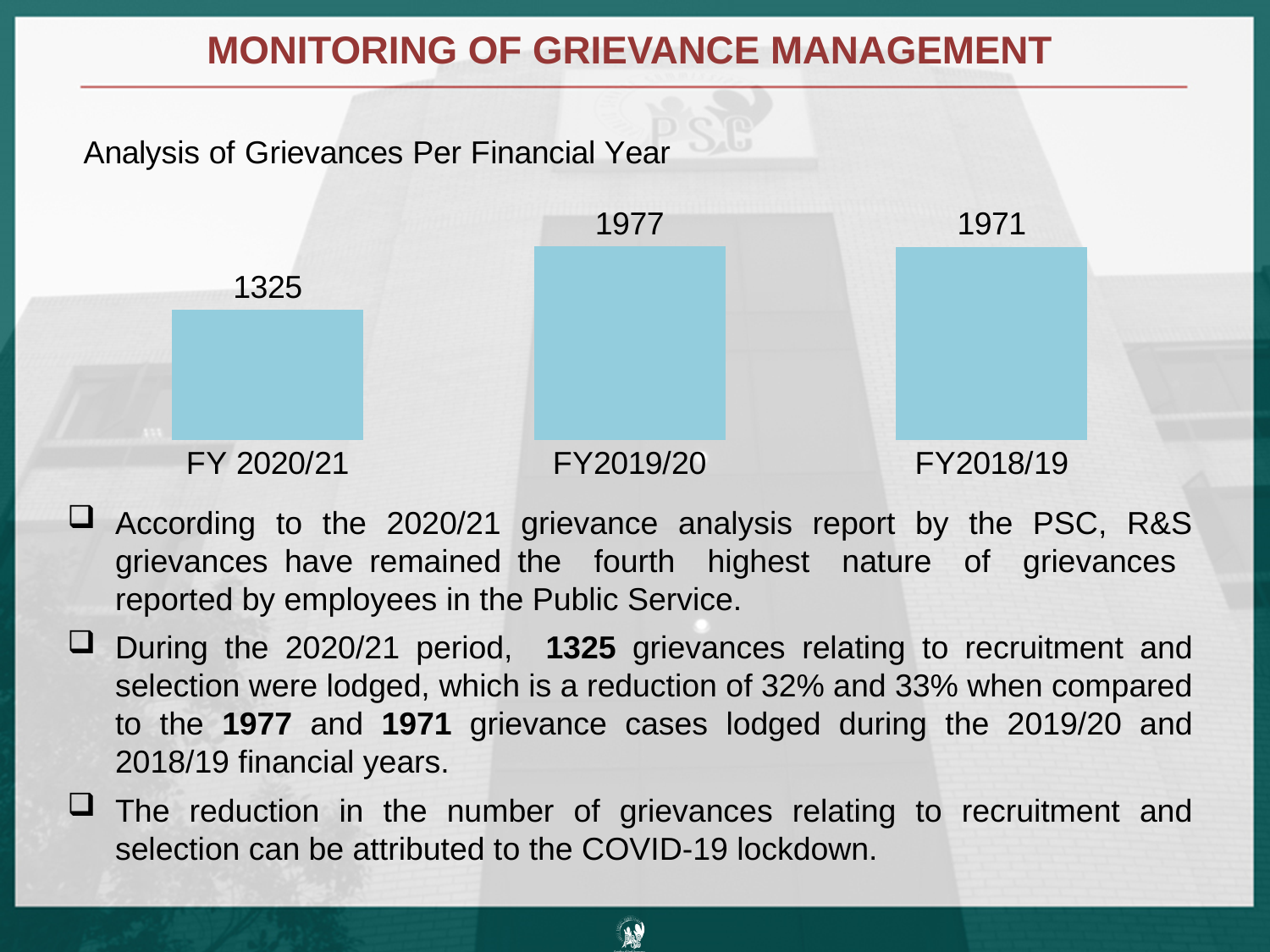
What is the difference between the values for FY2019/20 and FY2018/19? 6 Which is larger, the value for FY 2020/21 or the value for FY2018/19? FY2018/19 What is the heading above the chart? Analysis of Grievances Per Financial Year What colour are the bars in the chart? light blue How many financial years are shown in the chart? 3 What is the difference between the values for FY2019/20 and FY 2020/21? 652 What is the value for FY2019/20? 1977 Which financial year has the lowest value? FY 2020/21 What is the value for FY 2020/21? 1325 What kind of chart is shown on the slide? bar chart What is the value for FY2018/19? 1971 What is the total of the three values shown in the chart? 5273